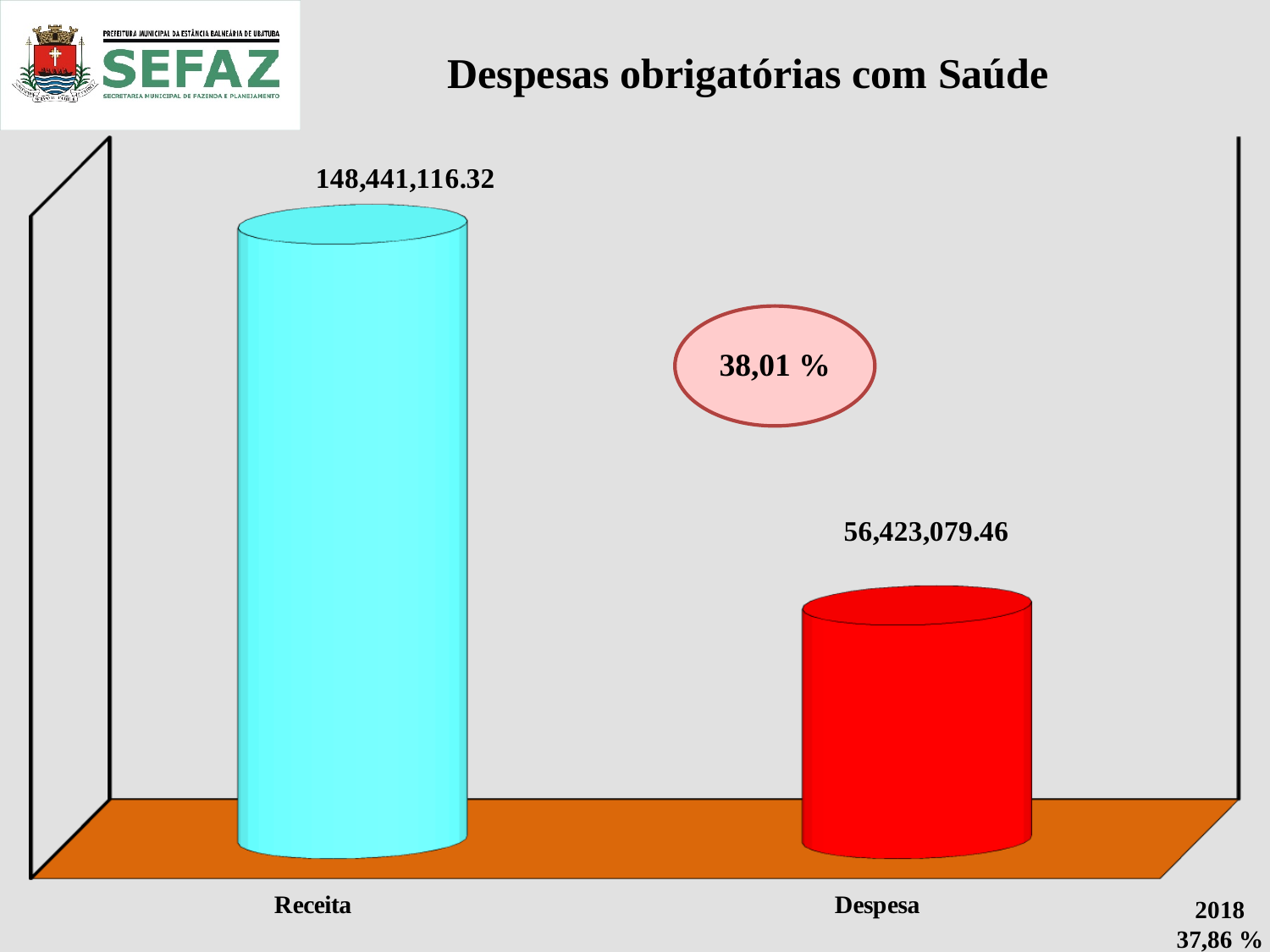
Which category has the higher value, Receita or Despesa? Receita Which category has the lowest value? Despesa What is the sum of the Receita and Despesa values? 204,864,195.78 Which category has the highest value? Receita What is the title of the chart? Despesas obrigatórias com Saúde What is the value shown for Receita? 148,441,116.32 What percentage is shown in the oval between the two bars? 38,01 % What kind of chart is shown on the slide? Bar chart What is the value shown for Despesa? 56,423,079.46 What is the difference between the Receita value and the Despesa value? 92,018,036.86 How many categories are plotted in the chart? 2